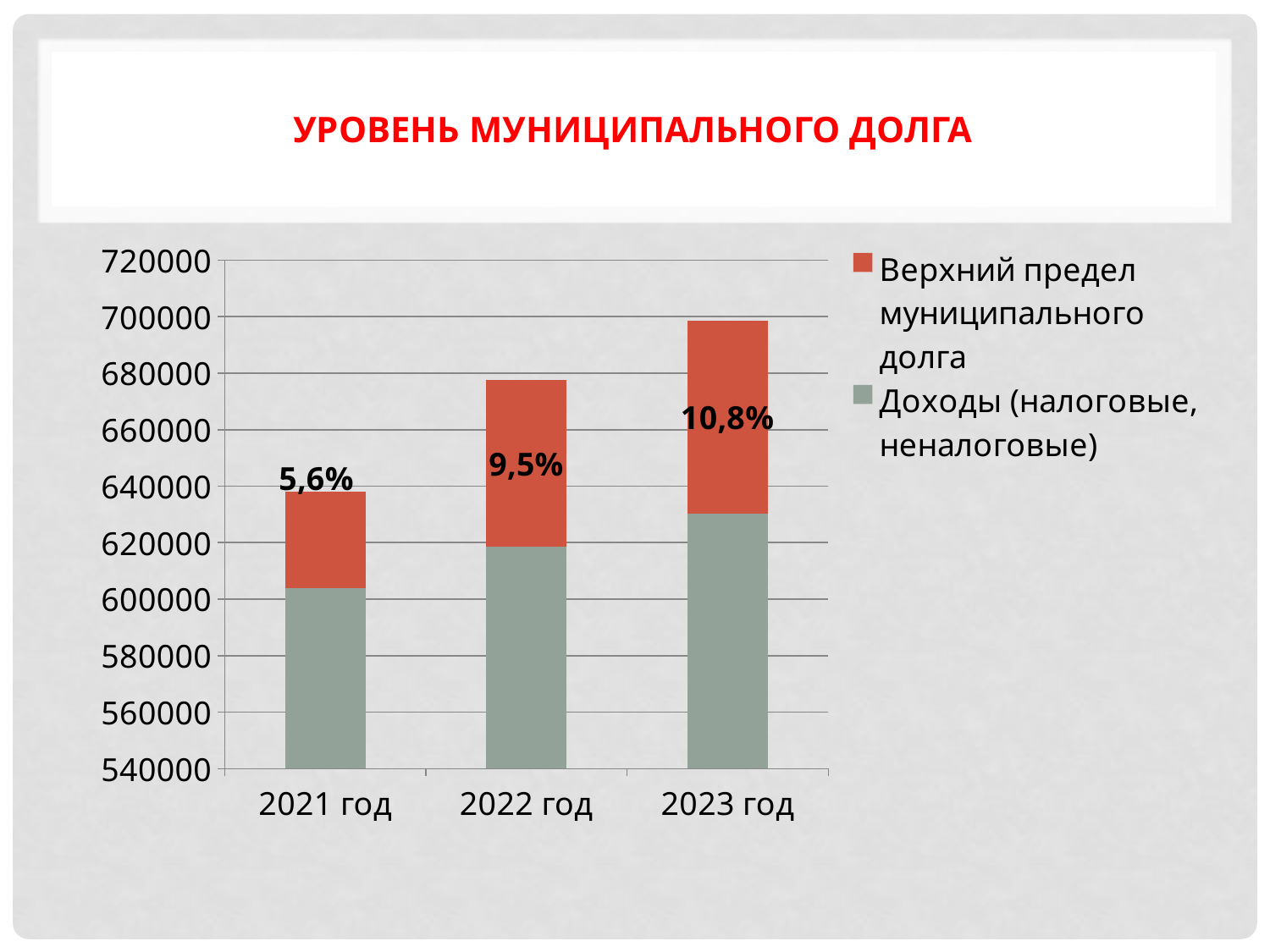
How many year categories are shown on the x axis? 3 Do the total bar heights rise or fall from 2021 год to 2023 год? rise What percentage label is shown on the bar for 2021 год? 5,6% What percentage label is shown on the bar for 2022 год? 9,5% Which year has the shortest stacked bar? 2021 год Is the value of Доходы (налоговые, неналоговые) for 2021 год greater or less than 600000? greater Which year has the tallest stacked bar? 2023 год How many series does the legend list? 2 What percentage label is shown on the bar for 2023 год? 10,8% What is the title of the chart? УРОВЕНЬ МУНИЦИПАЛЬНОГО ДОЛГА What type of chart is shown on the slide? stacked bar chart Is the top of the stacked bar for 2022 год greater or less than 660000? greater